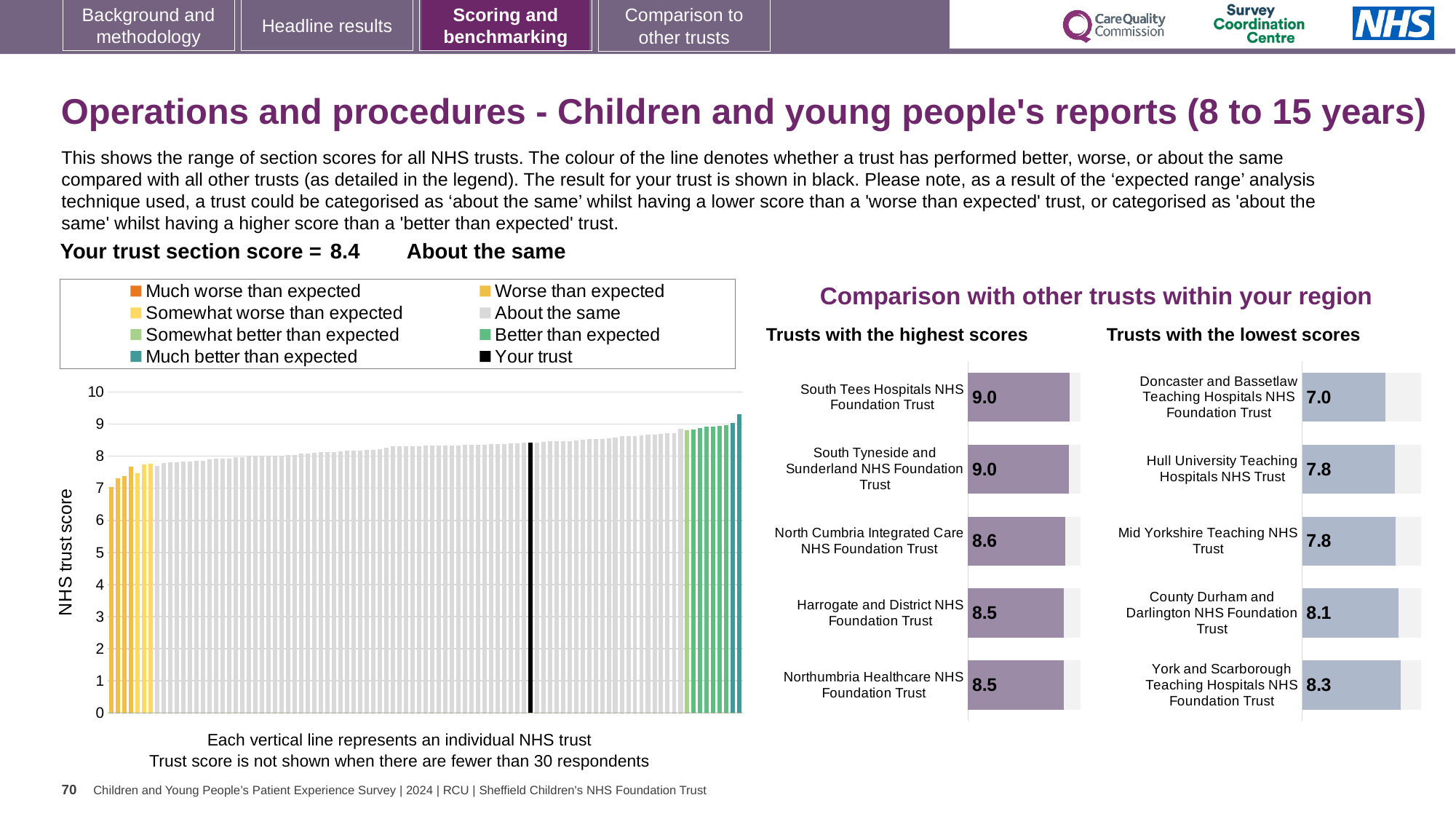
In the 'Trusts with the lowest scores' chart, which trust has the highest score? York and Scarborough Teaching Hospitals NHS Foundation Trust In the 'Trusts with the lowest scores' chart, which trust has the lowest score? Doncaster and Bassetlaw Teaching Hospitals NHS Foundation Trust In the 'Trusts with the lowest scores' chart, what is the score for Doncaster and Bassetlaw Teaching Hospitals NHS Foundation Trust? 7.0 How many trusts are shown in the 'Trusts with the lowest scores' chart? 5 In the 'Trusts with the highest scores' chart, what is the difference between the scores of North Cumbria Integrated Care NHS Foundation Trust and Harrogate and District NHS Foundation Trust? 0.1 In the 'Trusts with the highest scores' chart, what is the score for North Cumbria Integrated Care NHS Foundation Trust? 8.6 In the 'Trusts with the lowest scores' chart, what is the difference between the scores of York and Scarborough Teaching Hospitals NHS Foundation Trust and Doncaster and Bassetlaw Teaching Hospitals NHS Foundation Trust? 1.3 In the 'Trusts with the highest scores' chart, which has the larger score: South Tees Hospitals NHS Foundation Trust or Northumbria Healthcare NHS Foundation Trust? South Tees Hospitals NHS Foundation Trust What kind of chart is the large 'NHS trust score' chart on the left? Bar chart In the large 'NHS trust score' chart on the left, do the trust scores rise or fall from left to right? Rise In the 'Trusts with the lowest scores' chart, what is the score for County Durham and Darlington NHS Foundation Trust? 8.1 In the 'Trusts with the highest scores' chart, what is the score for Harrogate and District NHS Foundation Trust? 8.5